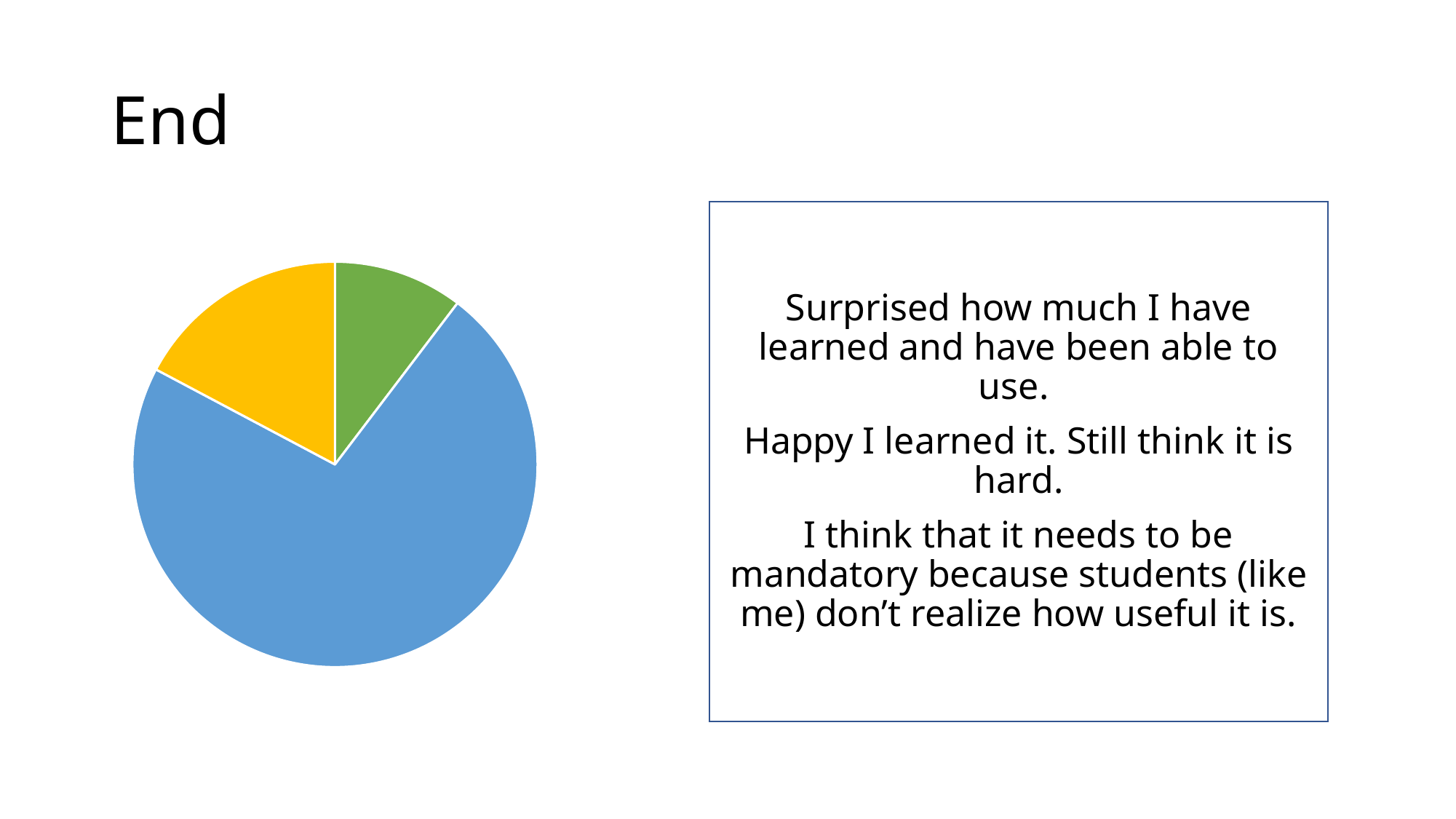
Does the pie chart have a legend? No Which colour slice is the largest in the pie chart? blue In the pie chart, which is larger, the blue slice or the yellow slice? blue In the pie chart, which is larger, the yellow slice or the green slice? yellow How many slices does the pie chart have? 3 What kind of chart is shown on the slide? pie chart Which colour slice is the smallest in the pie chart? green Does the blue slice take up more or less than half of the pie chart? more